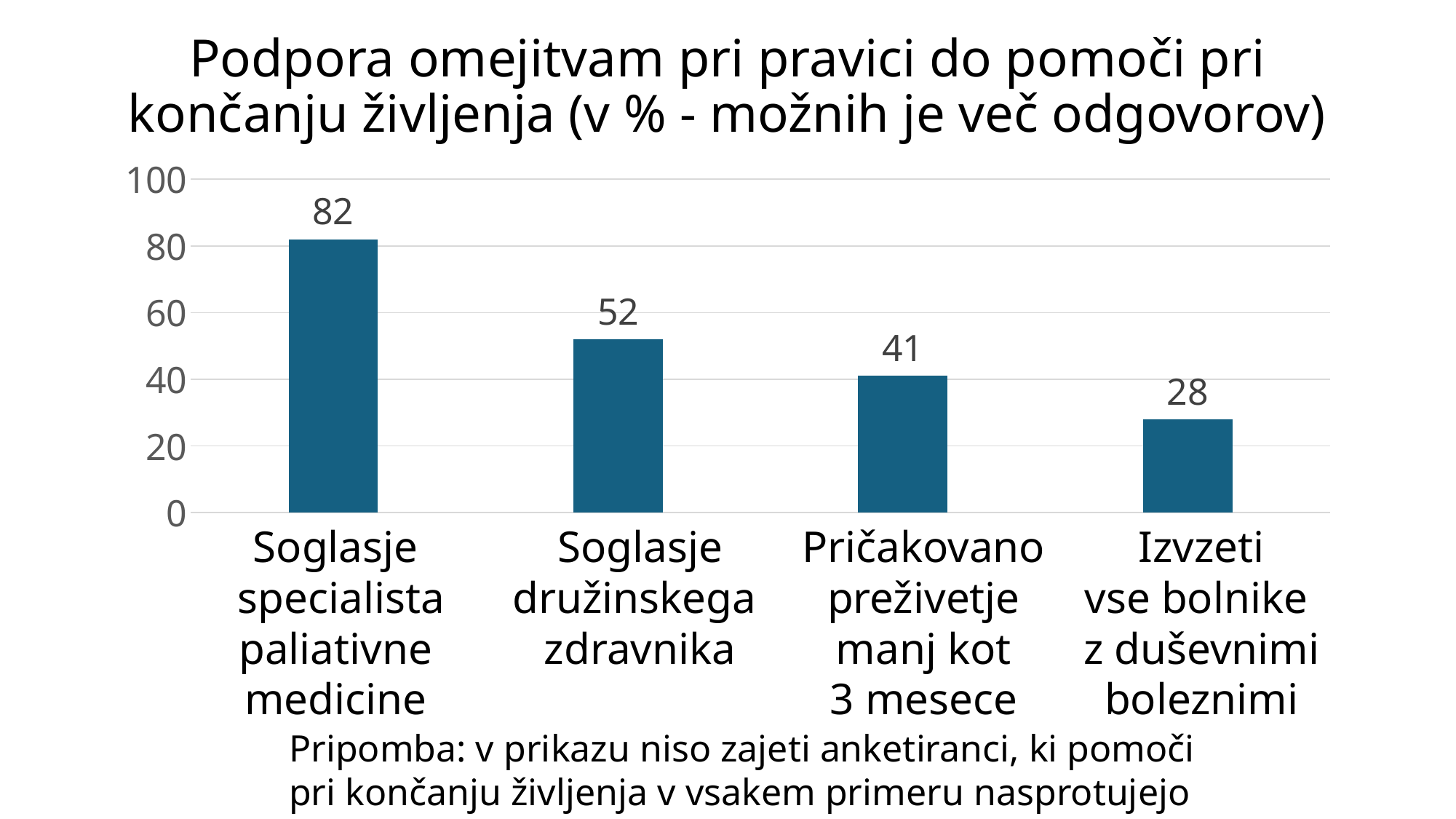
What is the difference between the values for "Pričakovano preživetje manj kot 3 mesece" and "Izvzeti vse bolnike z duševnimi boleznimi"? 13 What is the difference between the values for "Soglasje specialista paliativne medicine" and "Soglasje družinskega zdravnika"? 30 What is the value for "Soglasje družinskega zdravnika"? 52 Which is larger: the value for "Soglasje družinskega zdravnika" or for "Pričakovano preživetje manj kot 3 mesece"? Soglasje družinskega zdravnika What is the value for "Pričakovano preživetje manj kot 3 mesece"? 41 What kind of chart is shown on the slide? Bar chart Which category has the highest value? Soglasje specialista paliativne medicine Do the values rise or fall from left to right along the x axis? Fall What is the value for "Izvzeti vse bolnike z duševnimi boleznimi"? 28 What is the value for "Soglasje specialista paliativne medicine"? 82 Which category has the lowest value? Izvzeti vse bolnike z duševnimi boleznimi How many categories are shown in the chart? 4